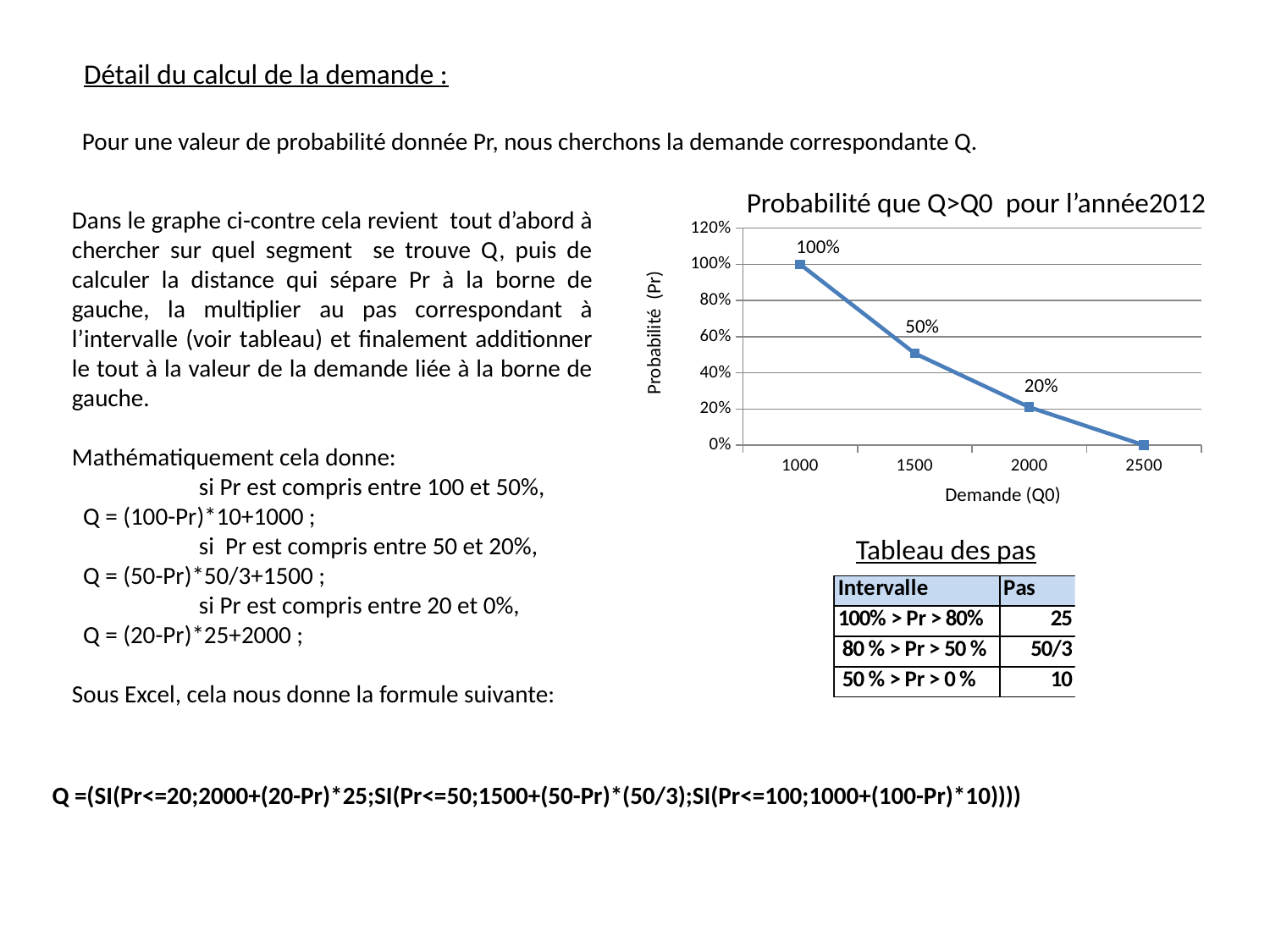
Do the probability values rise or fall as demand increases along the x axis? Fall At which demand value is the probability highest? 1000 What is the probability value plotted for a demand of 2500? 0% How many data points are plotted on the line? 4 What is the title of the chart? Probabilité que Q>Q0 pour l'année2012 What is the probability value plotted for a demand of 1000? 100% At which demand value is the probability lowest? 2500 Which has a higher probability: a demand of 1500 or a demand of 2000? 1500 What is the difference between the probability at a demand of 1000 and at a demand of 1500? 50% What type of chart is shown on the slide? Line chart What is the probability value plotted for a demand of 1500? 50% What is the probability value plotted for a demand of 2000? 20%